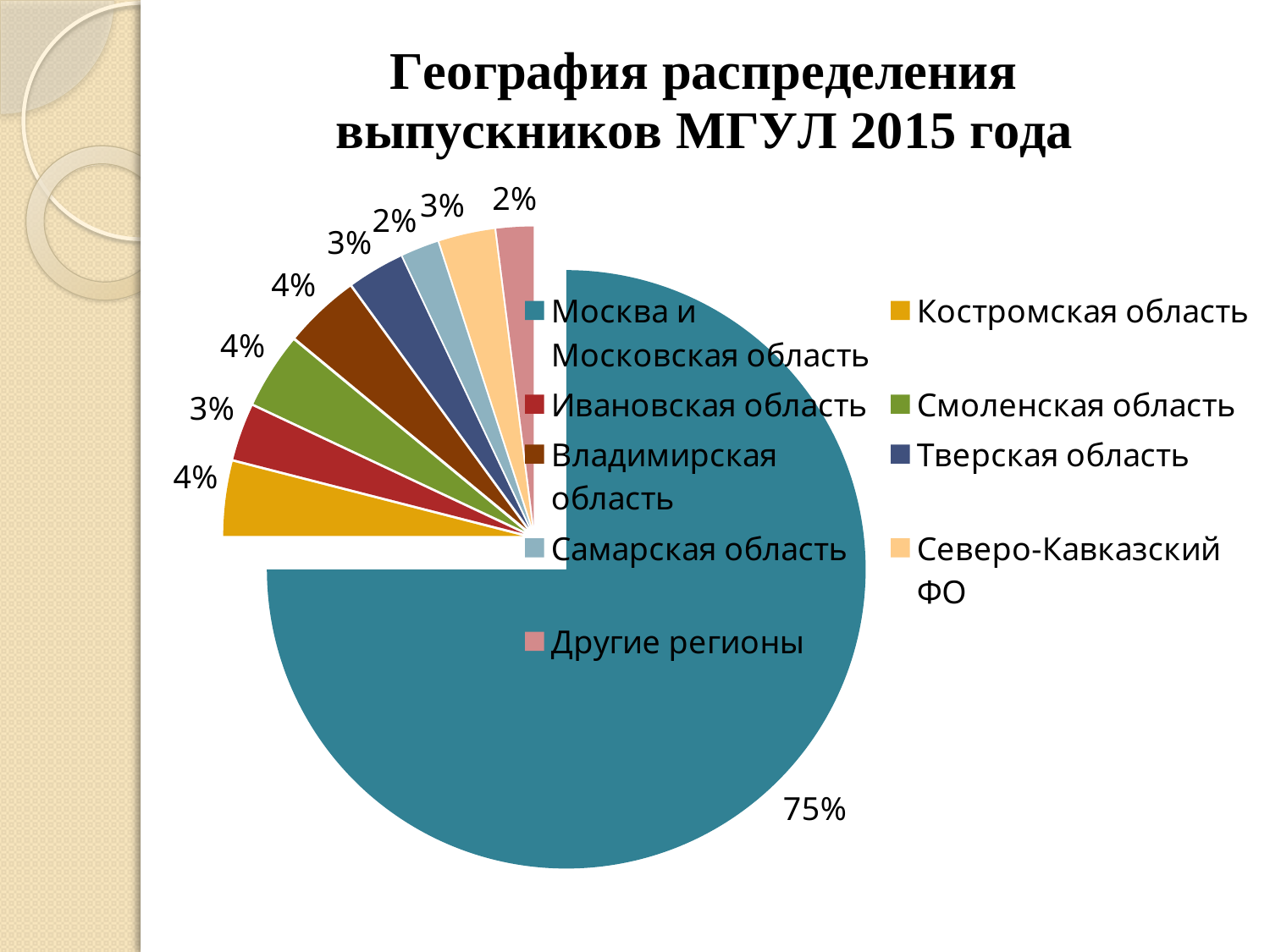
What is the title of the chart on the slide? География распределения выпускников МГУЛ 2015 года What share of graduates is shown for Другие регионы? 2% Which has the larger share, Владимирская область or Ивановская область? Владимирская область What kind of chart is shown on the slide? pie chart How many entries does the legend list? 9 What share of graduates is shown for Самарская область? 2% Which region has the largest share of the pie? Москва и Московская область What share of graduates is shown for Москва и Московская область? 75% How many slices does the pie chart have? 9 What share of graduates is shown for Северо-Кавказский ФО? 3% What share of graduates is shown for Костромская область? 4% By how many percentage points does the share for Москва и Московская область exceed the share for Костромская область? 71